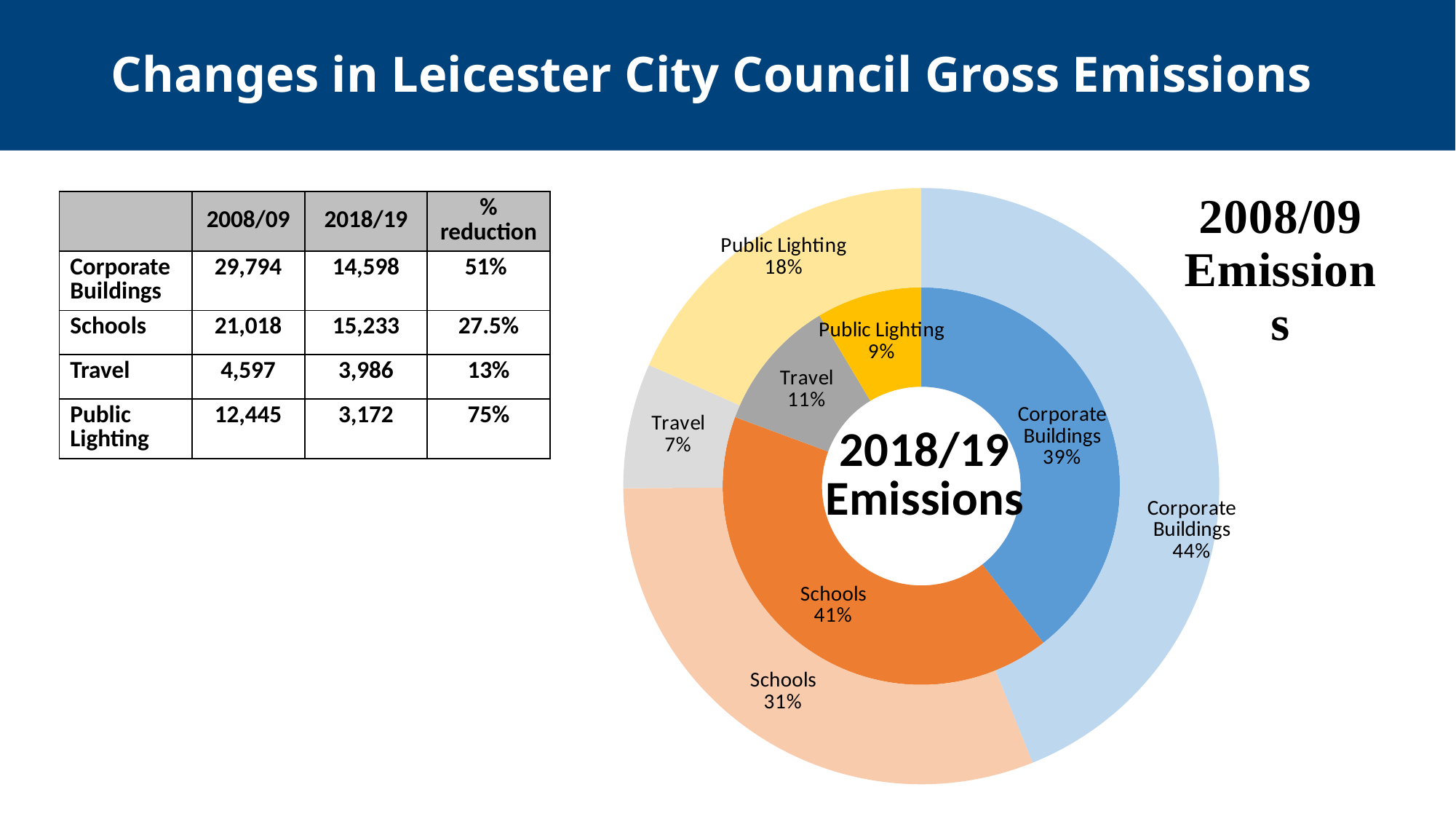
How many categories are shown in each ring of the doughnut chart? 4 In the inner ring (2018/19 Emissions), what share of emissions is Schools? 41% In the outer ring (2008/09 Emissions), what share of emissions is Public Lighting? 18% Which is larger in the 2018/19 Emissions ring: the Schools share or the Corporate Buildings share? Schools Which category has the smallest share in the 2018/19 Emissions ring? Public Lighting In the outer ring (2008/09 Emissions), what share of emissions is Corporate Buildings? 44% How many rings (series) does the doughnut chart have? 2 Which category has the largest share in the 2008/09 Emissions ring? Corporate Buildings What kind of chart is shown on the slide? Doughnut chart Which category has the smallest share in the 2008/09 Emissions ring? Travel What is the difference in percentage points between the Public Lighting share in 2008/09 and in 2018/19? 9 percentage points